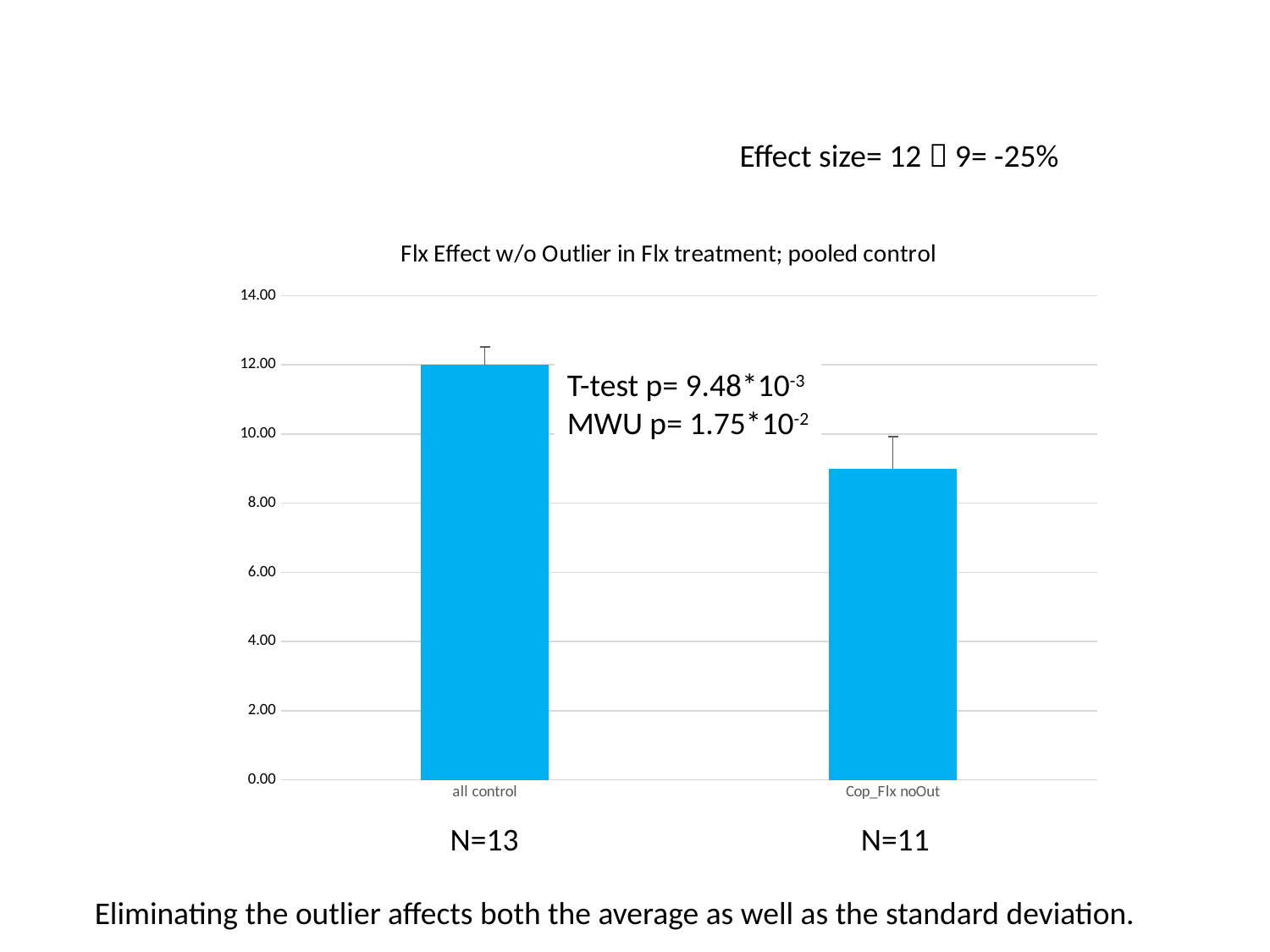
What is the title of the chart? Flx Effect w/o Outlier in Flx treatment; pooled control Is the value for all control greater or less than 10.00? greater What is the highest value shown on the y axis of the chart? 14.00 Which bar is taller, all control or Cop_Flx noOut? all control Which category has the highest bar? all control Do the bar values rise or fall from left to right along the x axis? fall What is the value of the all control bar? 12.00 How many categories are plotted on the x axis of the chart? 2 Is the value for Cop_Flx noOut greater or less than 8.00? greater Which category has the lowest bar? Cop_Flx noOut Is the value for Cop_Flx noOut greater or less than 10.00? less What kind of chart is shown on the slide? bar chart